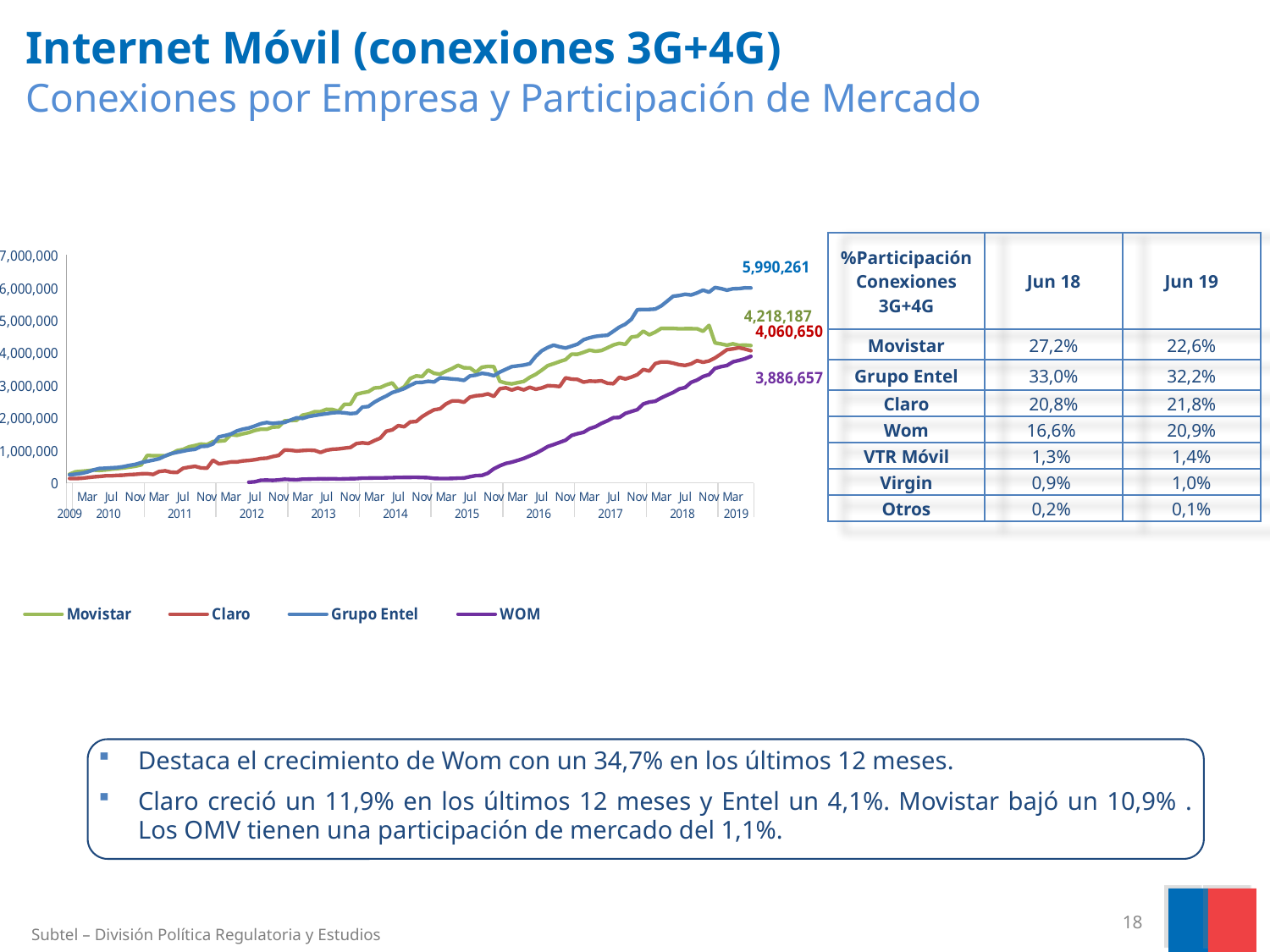
At the end of the chart, which is larger: the value for Claro or the value for WOM? Claro What kind of chart is shown on the slide? line chart What is the difference between the final values of Grupo Entel and Movistar? 1,772,074 What is the final labelled value for Grupo Entel on the chart? 5,990,261 What is the final labelled value for WOM on the chart? 3,886,657 What is the final labelled value for Movistar on the chart? 4,218,187 What is the final labelled value for Claro on the chart? 4,060,650 Which series has the highest value at the end of the chart? Grupo Entel Is the value for Grupo Entel in Mar 2015 greater or less than 2,000,000? greater Does the WOM line rise or fall over the period shown? rises How many series does the chart legend list? 4 Which series has the lowest value at the end of the chart? WOM